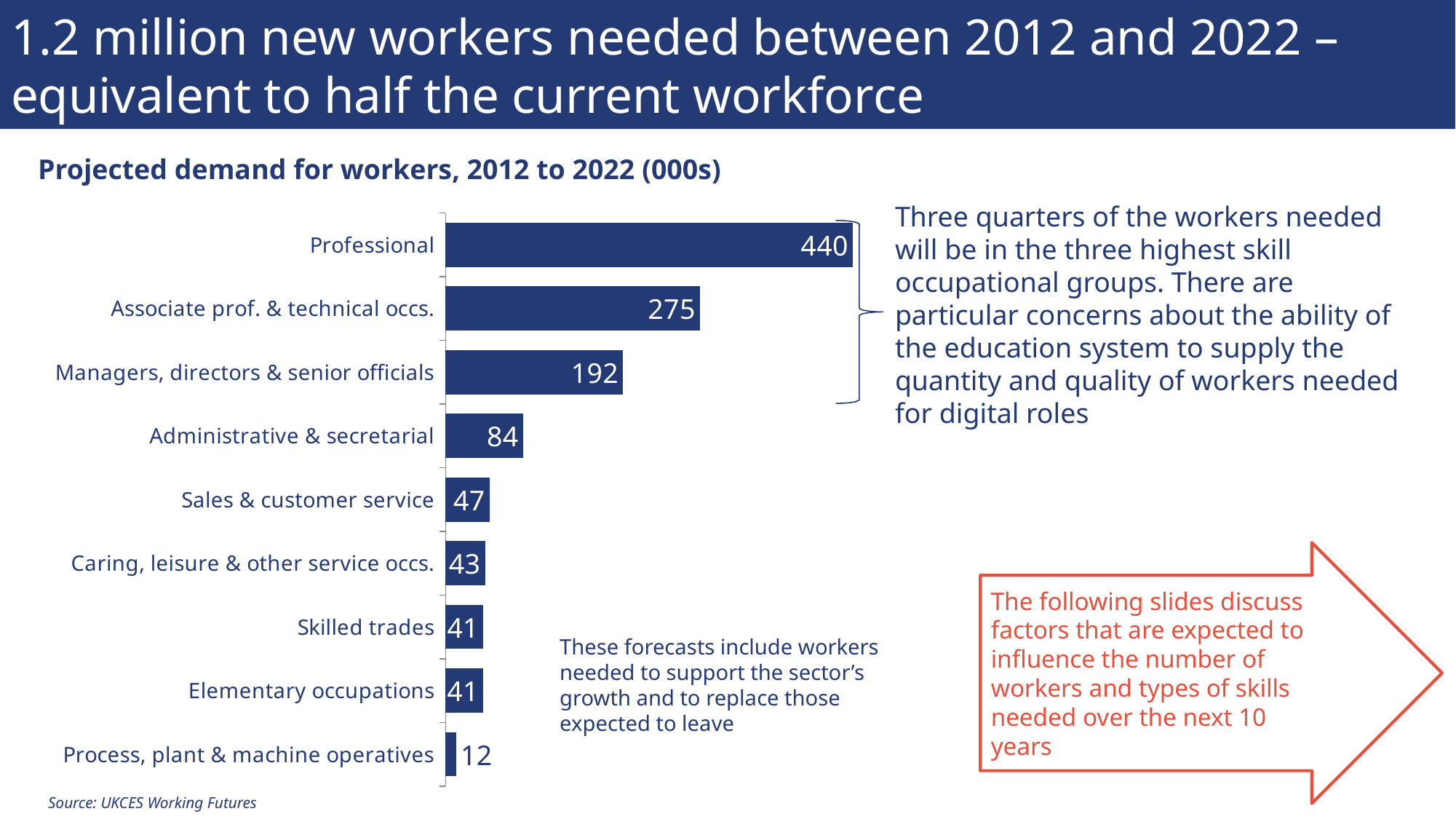
What is the difference between the projected demand for Managers, directors & senior officials and Administrative & secretarial? 108 What is the projected demand for workers in Administrative & secretarial? 84 Which occupational category has the lowest projected demand for workers? Process, plant & machine operatives How many occupational categories are shown in the chart? 9 What is the projected demand for workers in the Professional category? 440 What kind of chart is used to show projected demand for workers? Bar chart Which occupational category has the highest projected demand for workers? Professional Which has a higher projected demand: Sales & customer service or Caring, leisure & other service occs.? Sales & customer service What is the projected demand for workers in Process, plant & machine operatives? 12 What is the difference between the projected demand for Professional and Associate prof. & technical occs.? 165 What is the title of the chart? Projected demand for workers, 2012 to 2022 (000s) What is the source cited for the chart? UKCES Working Futures